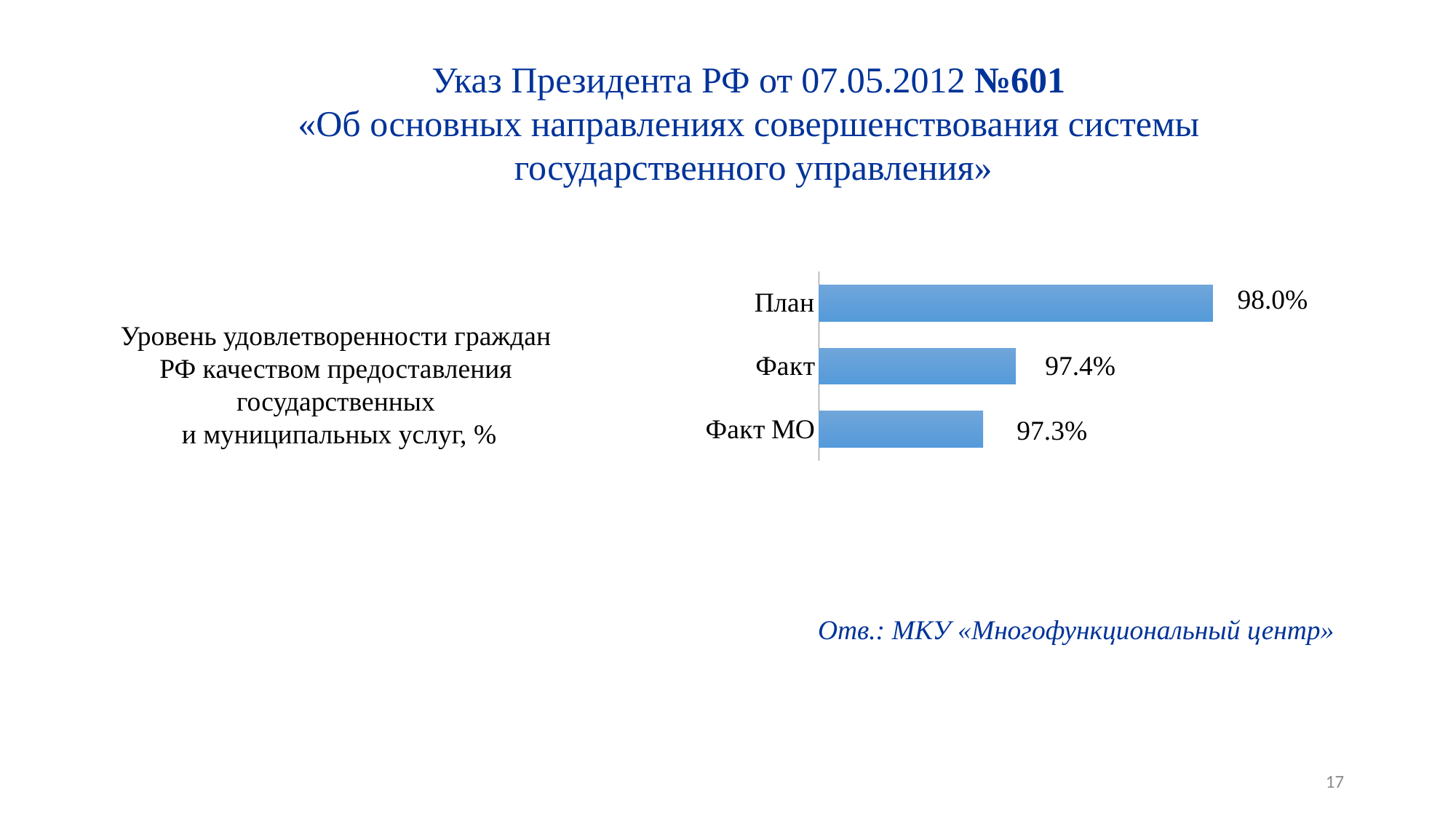
What is the difference between the values for План and Факт? 0.6% What indicator does the chart describe, according to the text to its left? Уровень удовлетворенности граждан РФ качеством предоставления государственных и муниципальных услуг, % Which category has the highest value? План What is the value for Факт? 97.4% Which category has the lowest value? Факт МО What is the difference between the values for Факт and Факт МО? 0.1% Which is larger, the value for План or the value for Факт МО? План What kind of chart is shown on the slide? bar chart What is the value for Факт МО? 97.3% What is the value for План? 98.0% How many categories are shown in the chart? 3 What is the difference between the values for План and Факт МО? 0.7%